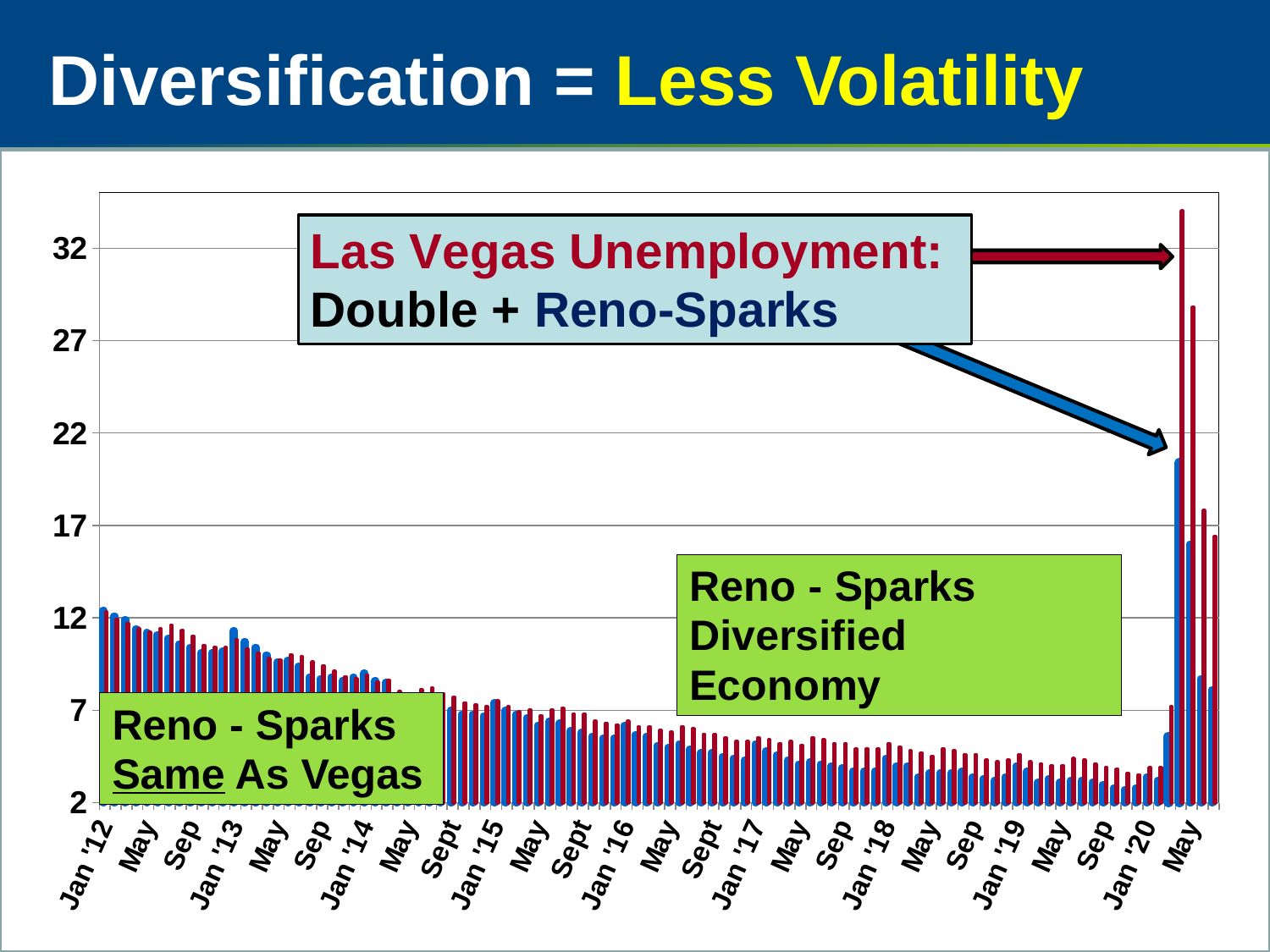
Is the highest Reno-Sparks unemployment bar in 2020 greater or less than 17? greater What kind of chart is shown on the slide? bar chart Is the Las Vegas unemployment value for Jan '16 greater or less than 12? less Which colour of bars represents Las Vegas unemployment in the chart? red Is the Las Vegas unemployment value for Jan '12 greater or less than 17? less What is the title of the slide containing the chart? Diversification = Less Volatility Do the unemployment values generally rise or fall from Jan '12 to Jan '20? fall At the 2020 peak, which is larger, the Las Vegas unemployment bar or the Reno-Sparks unemployment bar? Las Vegas Which series reaches the highest value on the chart, Las Vegas or Reno-Sparks? Las Vegas